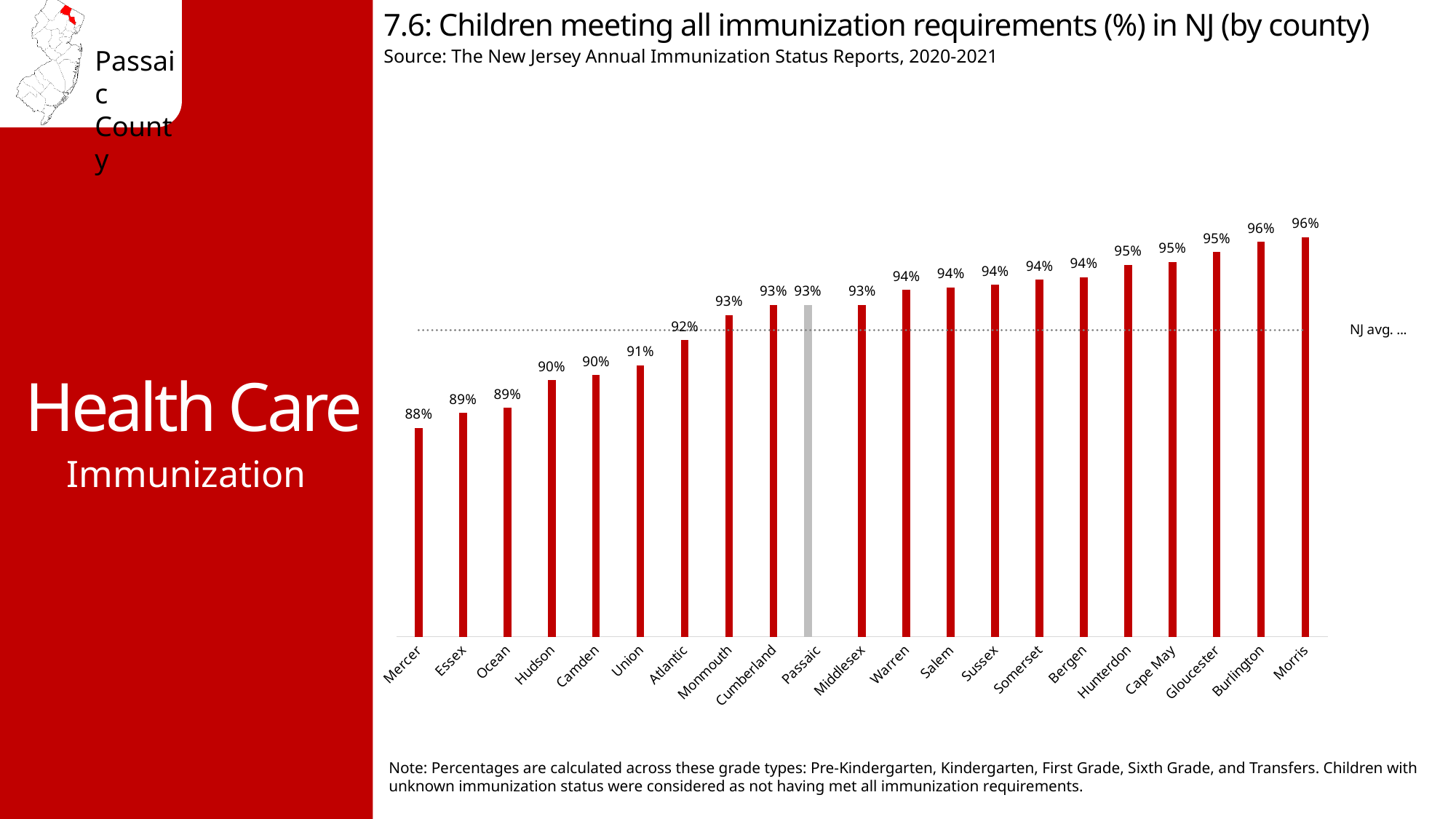
Which has a higher value, Atlantic or Salem? Salem Do the values rise or fall from left to right along the x axis? Rise Which has a higher value, Hudson or Union? Union What is the difference between the values for Morris and Mercer? 8 percentage points Which county's bar is coloured grey instead of red? Passaic What is the value for Mercer? 88% What is the value for Passaic? 93% Which county has the lowest percentage of children meeting all immunization requirements? Mercer What is the value for Hunterdon? 95% How many counties are shown on the chart? 21 What is the difference between the values for Bergen and Passaic? 1 percentage point What kind of chart is this? Bar chart